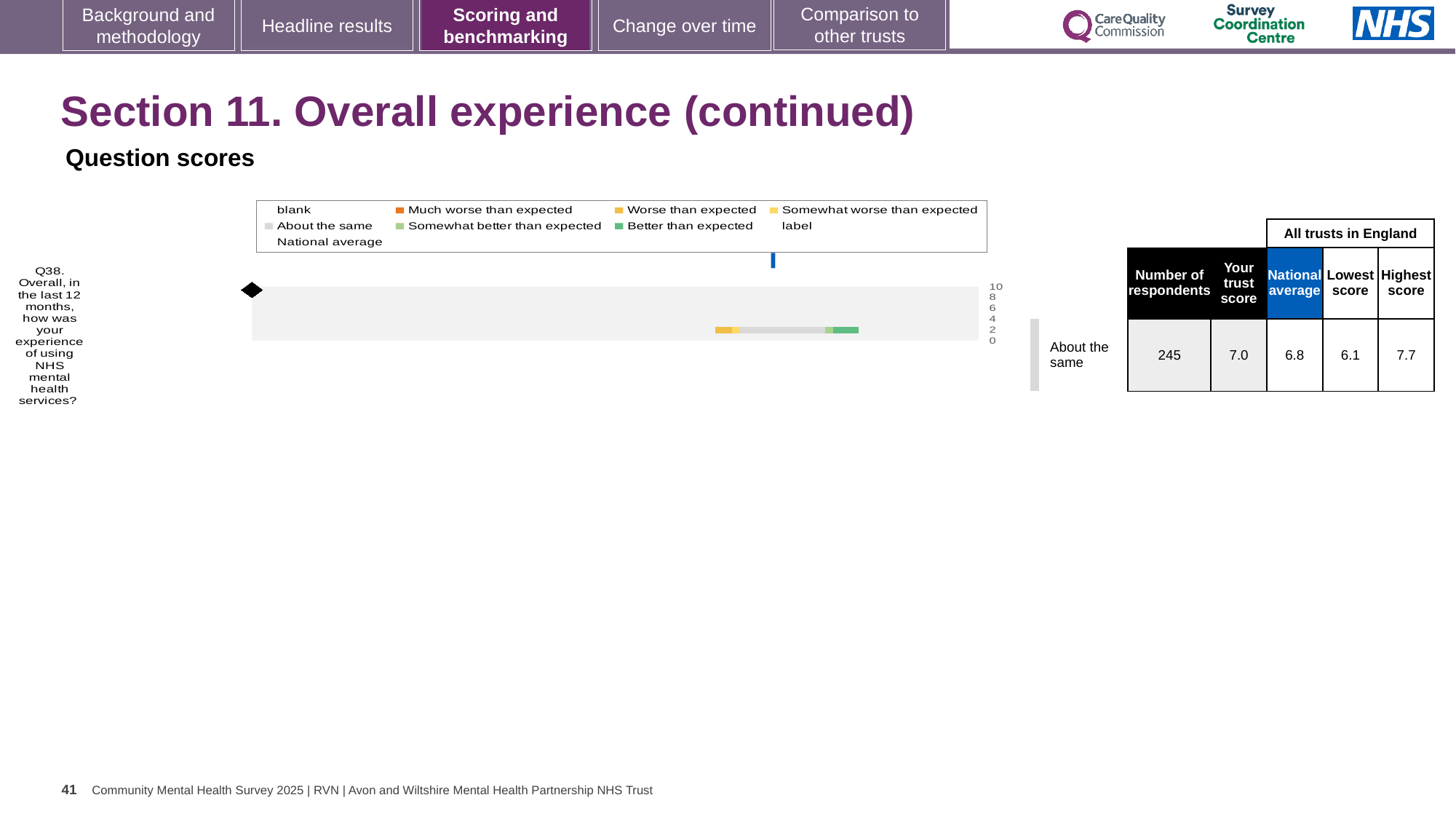
What is the highest score among all trusts in England for Q38? 7.7 What is the national average score for Q38? 6.8 What is the lowest score among all trusts in England for Q38? 6.1 What is the 'Your trust score' value for Q38 in the table? 7.0 Which is larger for Q38, the trust score or the national average? the trust score (7.0) What kind of chart is used to show the Q38 question score? bar chart How many respondents answered Q38? 245 By how much does the trust score for Q38 exceed the national average? 0.2 What is the difference between the highest and lowest scores for Q38? 1.6 Which legend entry is shown in orange? Much worse than expected How many survey questions are plotted on this chart? 1 Which benchmark category is Q38 assigned to on this slide? About the same